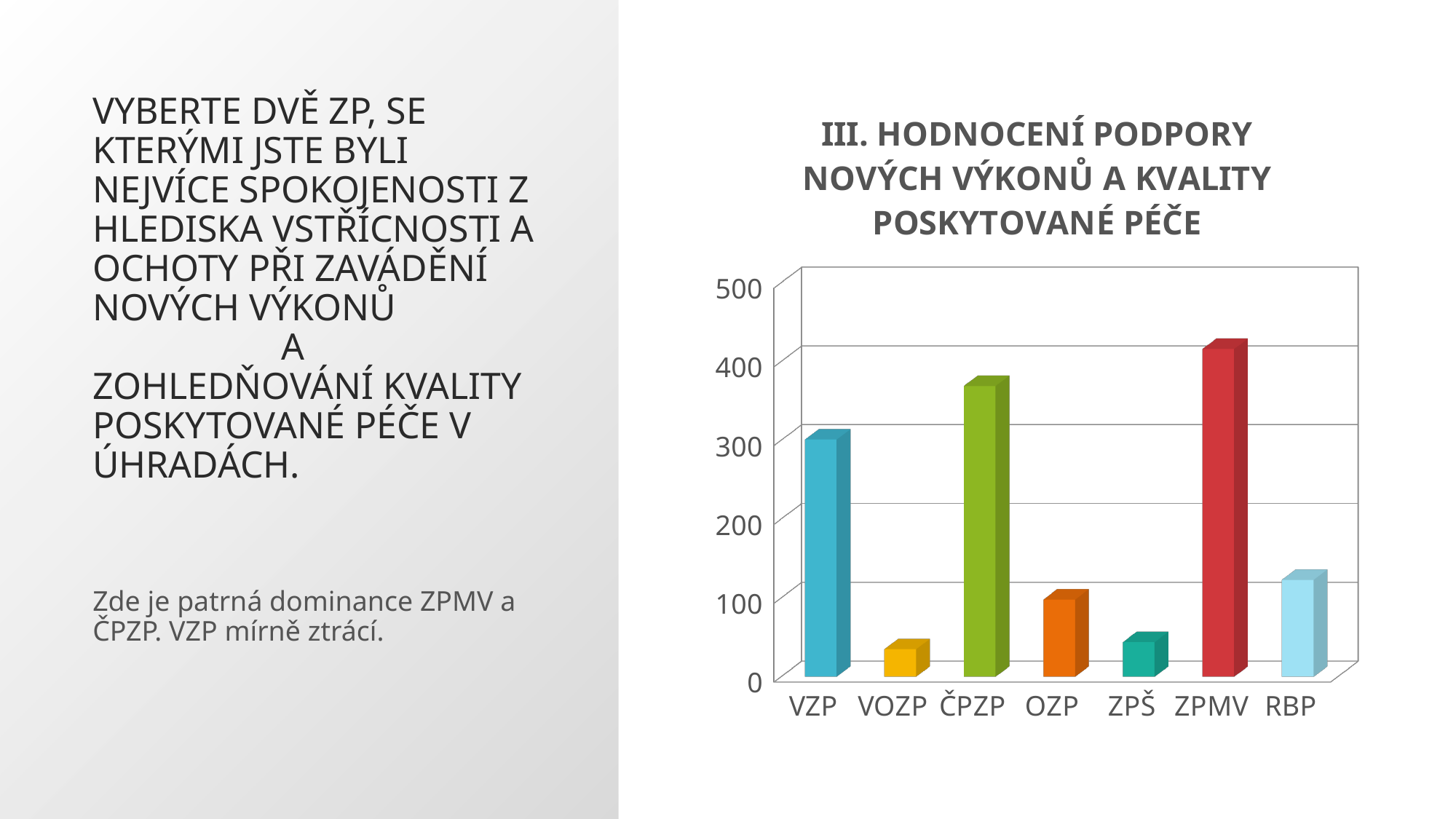
Is the value for VZP greater or less than 200? greater Which has a larger value, ČPZP or VZP? ČPZP Which has a larger value, RBP or ZPŠ? RBP What is the title of the chart? III. HODNOCENÍ PODPORY NOVÝCH VÝKONŮ A KVALITY POSKYTOVANÉ PÉČE Is the value for VOZP greater or less than 100? less Which category has the highest value in the chart? ZPMV How many categories are shown on the x axis of the chart? 7 Is the value for RBP greater or less than 100? greater What kind of chart is shown on the slide? bar chart